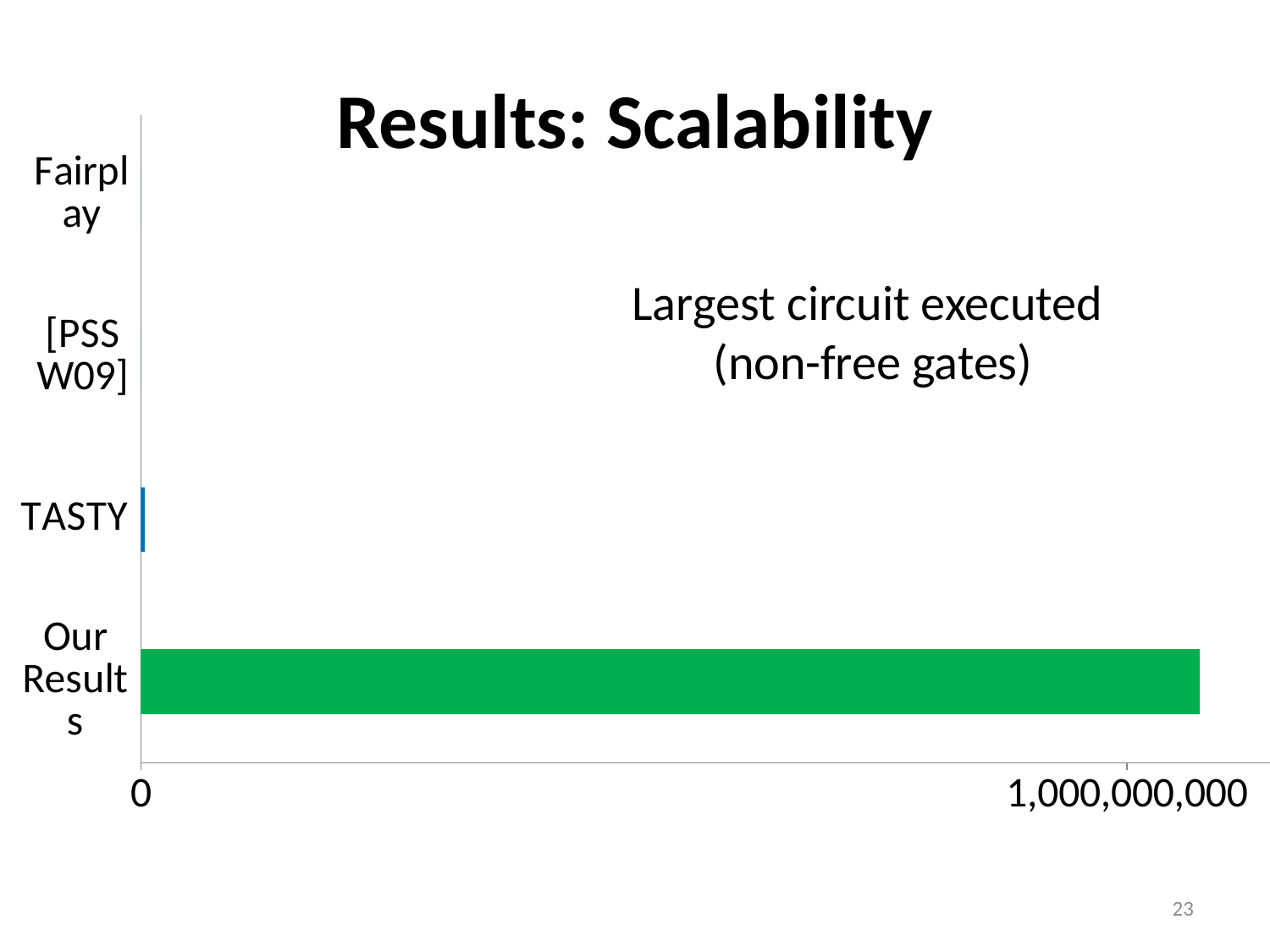
What is the largest tick label shown on the horizontal axis? 1,000,000,000 Which has a larger value, TASTY or Fairplay? TASTY Is the value for Our Results greater or less than 1,000,000,000? greater Which has a larger value, Our Results or TASTY? Our Results What does the text label inside the chart area say the chart measures? Largest circuit executed (non-free gates) How many categories are listed on the vertical axis of the chart? 4 Which category appears at the top of the vertical axis? Fairplay What kind of chart is shown on the slide? Bar chart Is the value for TASTY greater or less than 1,000,000,000? less What is the title of the slide containing the chart? Results: Scalability Which category has the highest value in the chart? Our Results